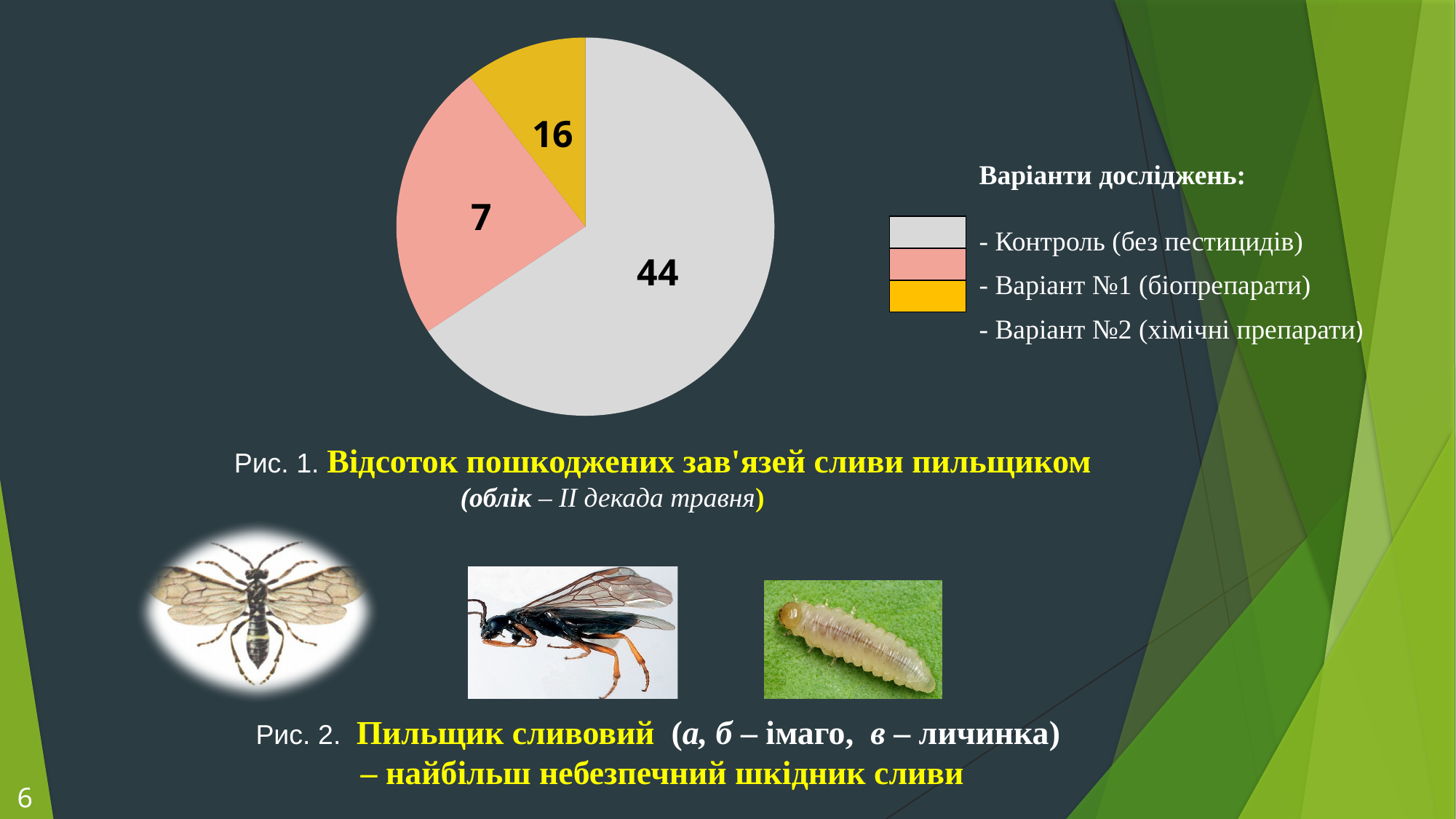
Which variant has the highest value in the pie chart? Контроль (без пестицидів) What is the heading of the legend next to the pie chart? Варіанти досліджень: What is the value for Контроль (без пестицидів) in the pie chart? 44 What is the difference between the values for Контроль and Варіант №1? 37 Which is larger: the value for Контроль or the value for Варіант №2? Контроль What colour represents Варіант №2 (хімічні препарати) in the pie chart? yellow Which variant has the lowest value in the pie chart? Варіант №1 (біопрепарати) What type of chart is shown on the slide? pie chart How many slices does the pie chart have? 3 What is the value for Варіант №1 (біопрепарати) in the pie chart? 7 What is the value for Варіант №2 (хімічні препарати) in the pie chart? 16 What is the difference between the values for Контроль and Варіант №2? 28